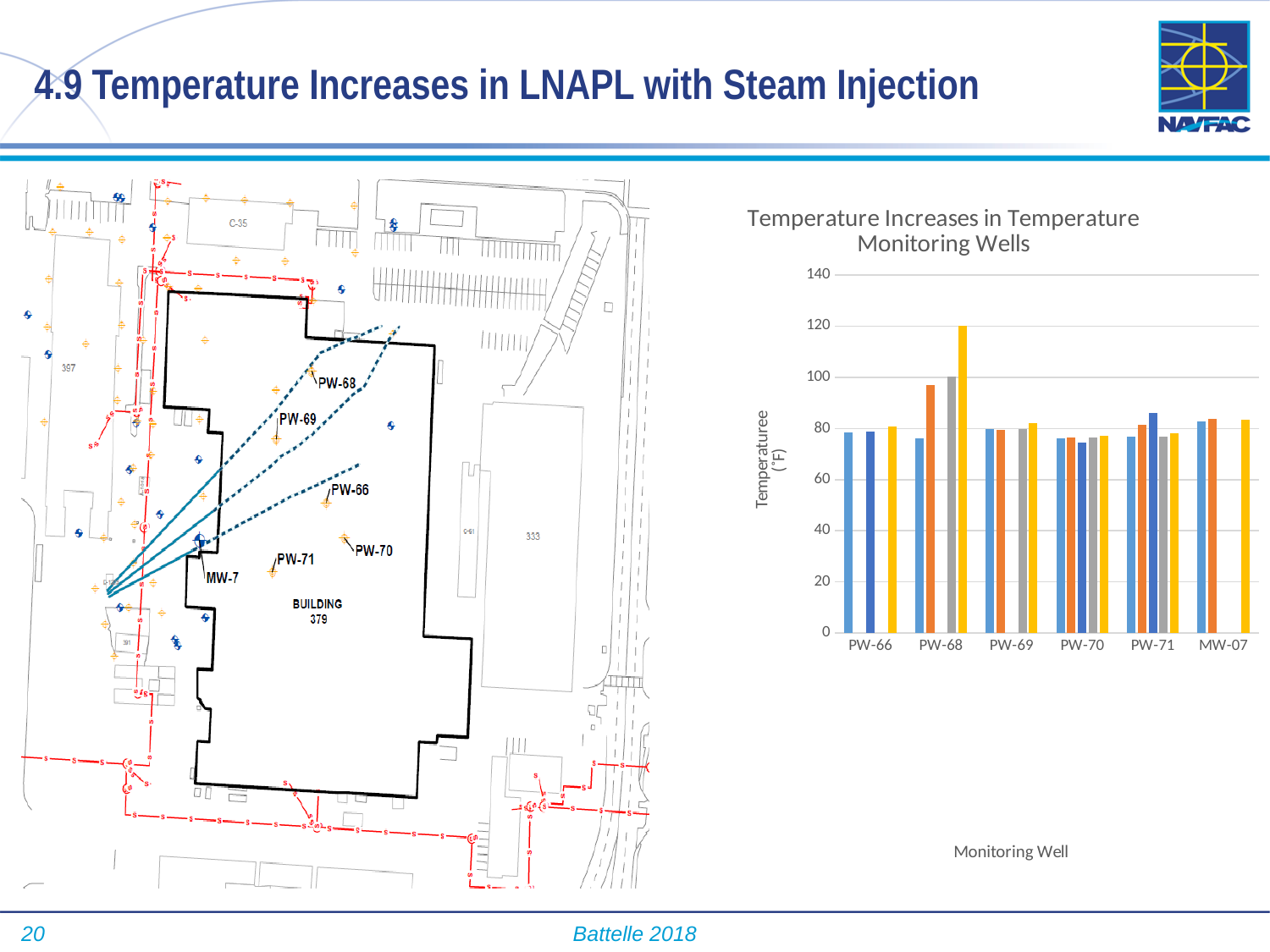
Is the tallest bar for PW-68 greater or less than 100? greater Is the tallest bar for PW-68 larger than the tallest bar for PW-71? Yes Which monitoring well has the tallest bar in the chart? PW-68 What is the title of the chart? Temperature Increases in Temperature Monitoring Wells Are the bars for PW-70 greater or less than 100? less Are the bars for PW-66 greater or less than 100? less How many monitoring wells are shown on the x axis of the chart? 6 What is the x-axis title of the chart? Monitoring Well What kind of chart is shown on the slide? bar chart